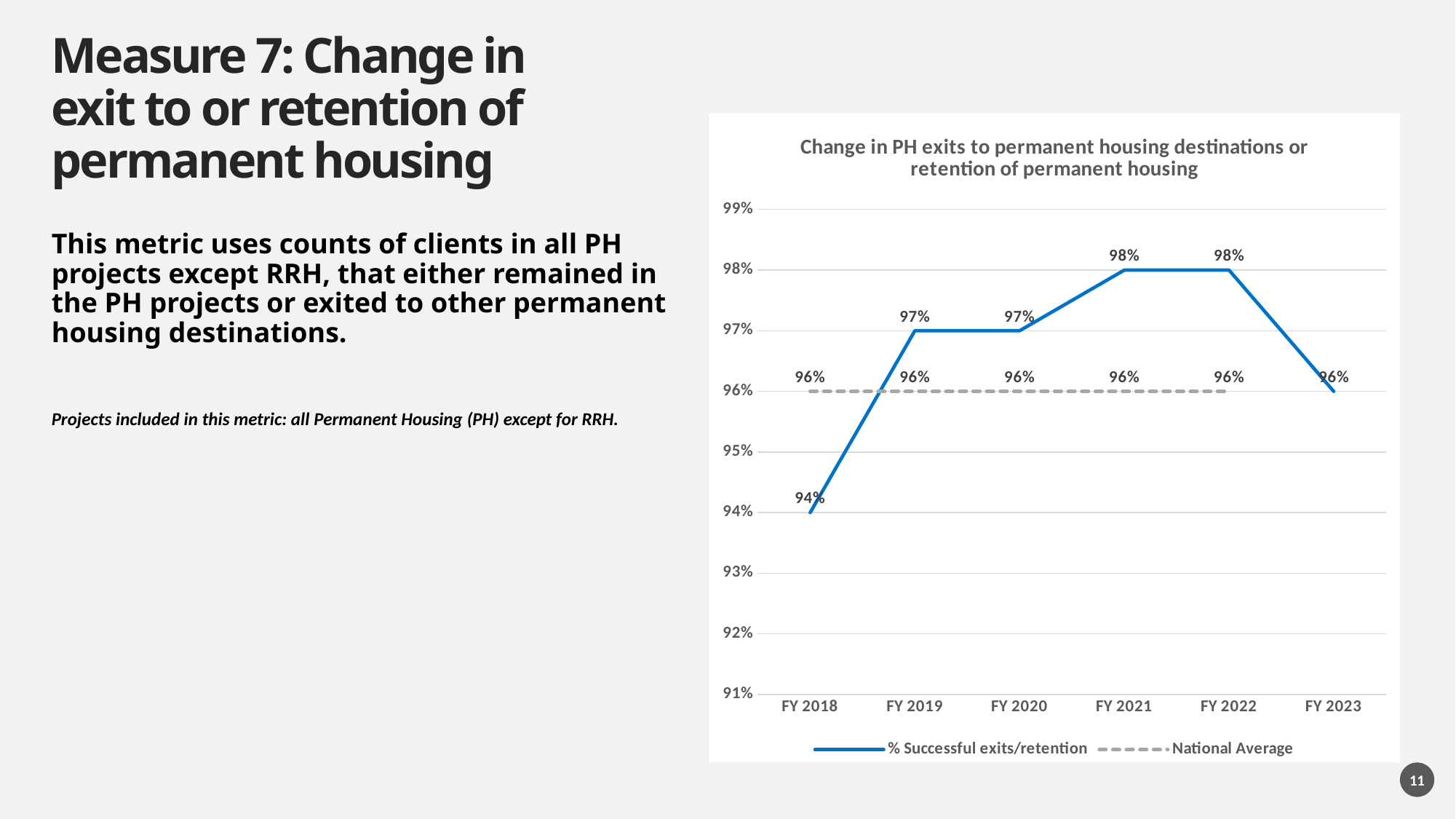
How many fiscal years are shown on the x axis? 6 What is the % Successful exits/retention value for FY 2018? 94% What is the difference between the % Successful exits/retention value in FY 2022 and in FY 2023? 2% What is the difference between the % Successful exits/retention value and the National Average in FY 2018? 2% Does the % Successful exits/retention value rise or fall from FY 2018 to FY 2019? rise What is the % Successful exits/retention value for FY 2023? 96% What type of chart is shown on the slide? line chart How many series does the legend list? 2 In which fiscal year is the % Successful exits/retention value lowest? FY 2018 What is the % Successful exits/retention value for FY 2021? 98% Which is larger in FY 2019: the % Successful exits/retention value or the National Average? % Successful exits/retention What is the National Average value for FY 2020? 96%